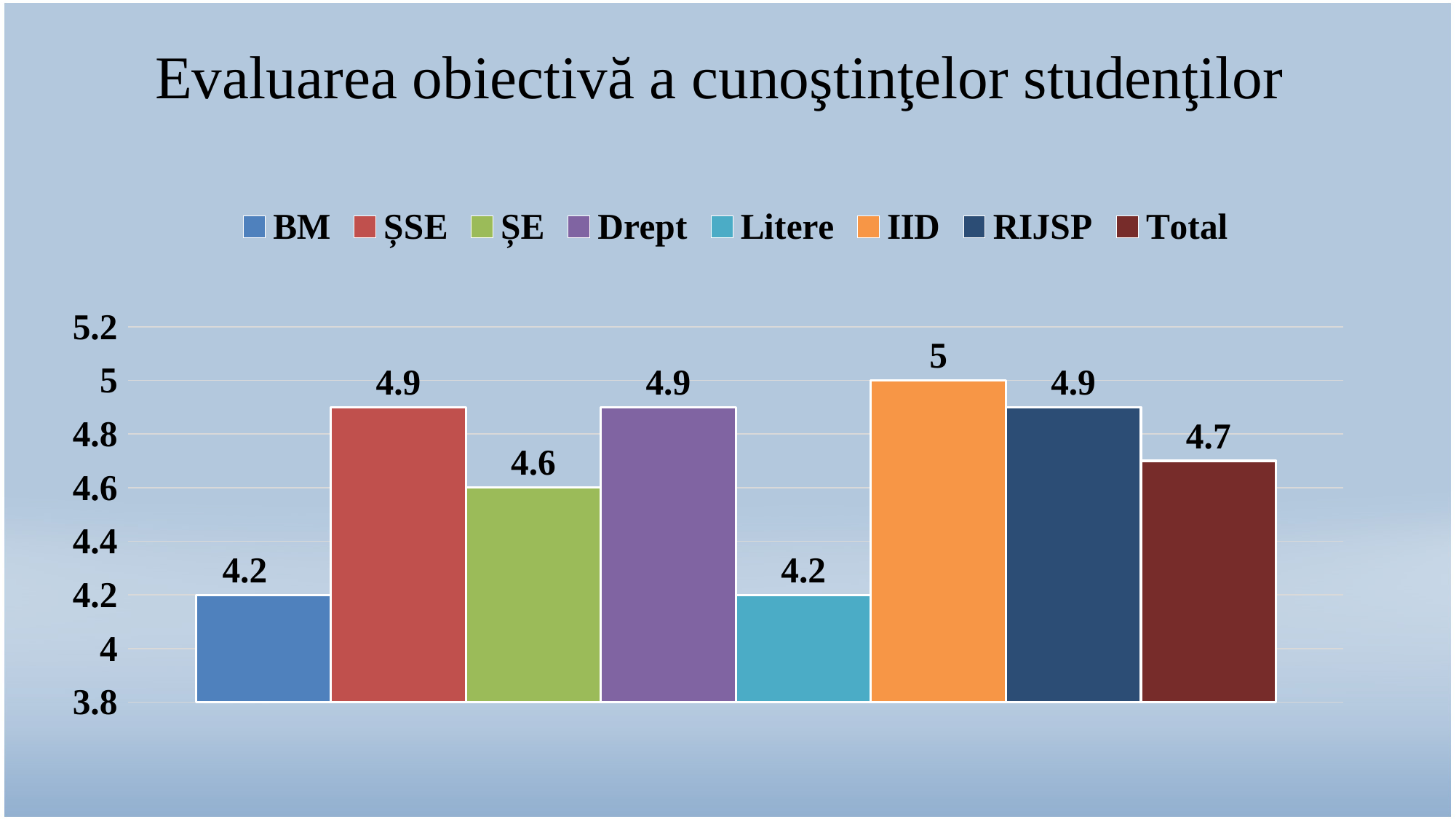
What is the difference between the values for ȘSE and ȘE? 0.3 How many series does the legend list? 8 What is the value for Total? 4.7 Which is larger, the value for Drept or the value for Total? Drept What is the difference between the values for IID and BM? 0.8 What kind of chart is shown on the slide? bar chart What is the value for ȘE? 4.6 What is the value for Litere? 4.2 What is the title of the chart? Evaluarea obiectivă a cunoştinţelor studenţilor Is the value for ȘE greater or less than 4.8? less Which series has the highest value? IID What is the value for IID? 5